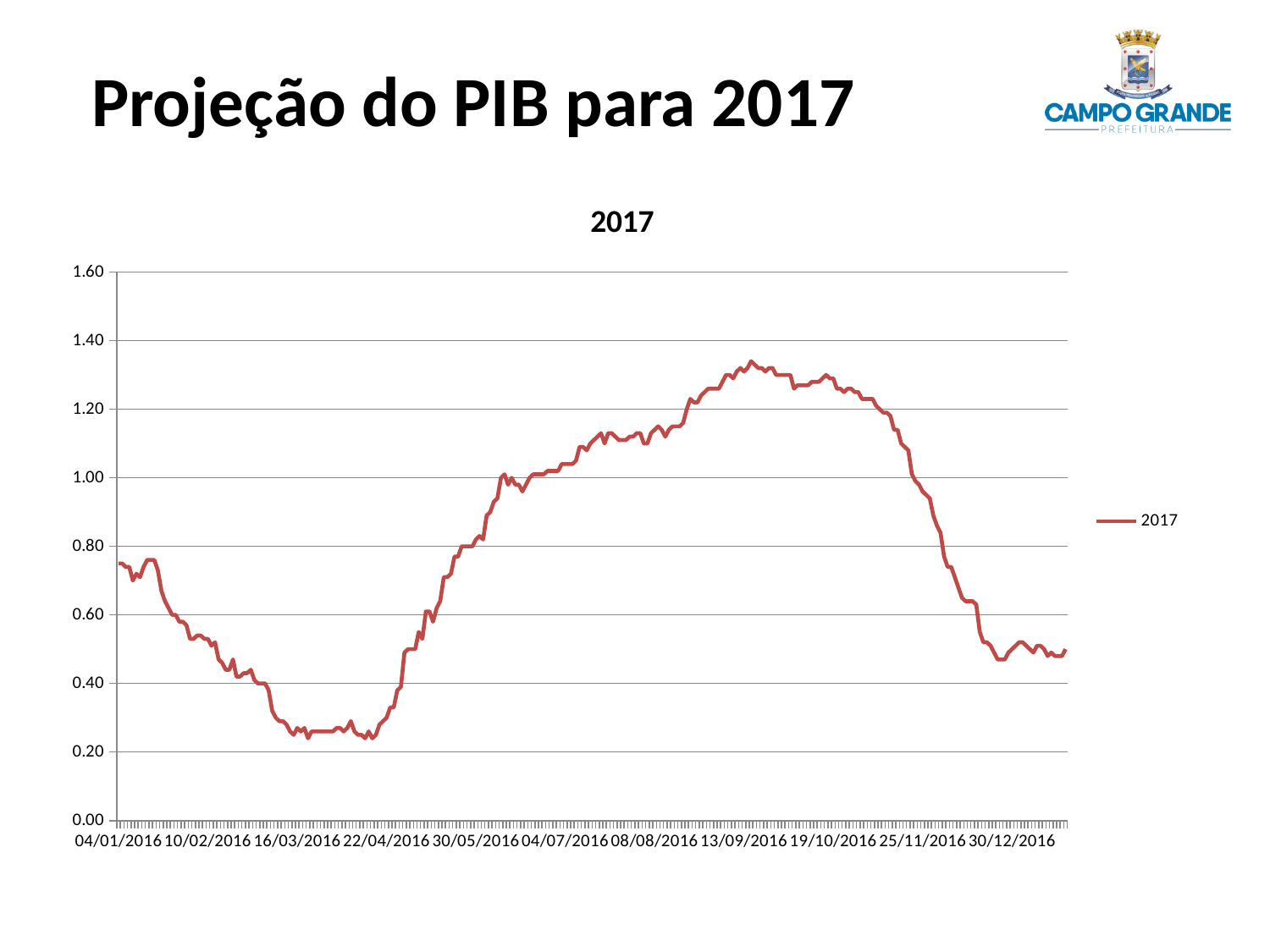
Is the value for 13/09/2016 greater or less than 1.20? greater What is the title of the chart? 2017 Is the value for 04/01/2016 greater or less than 0.60? greater Is the value for 22/04/2016 greater or less than 0.40? less What kind of chart is shown on the slide? line chart What is the highest value labelled on the vertical axis? 1.60 How many series does the legend list? 1 Around which labelled date does the line reach its highest value? 13/09/2016 Does the line rise or fall between 22/04/2016 and 13/09/2016? rise